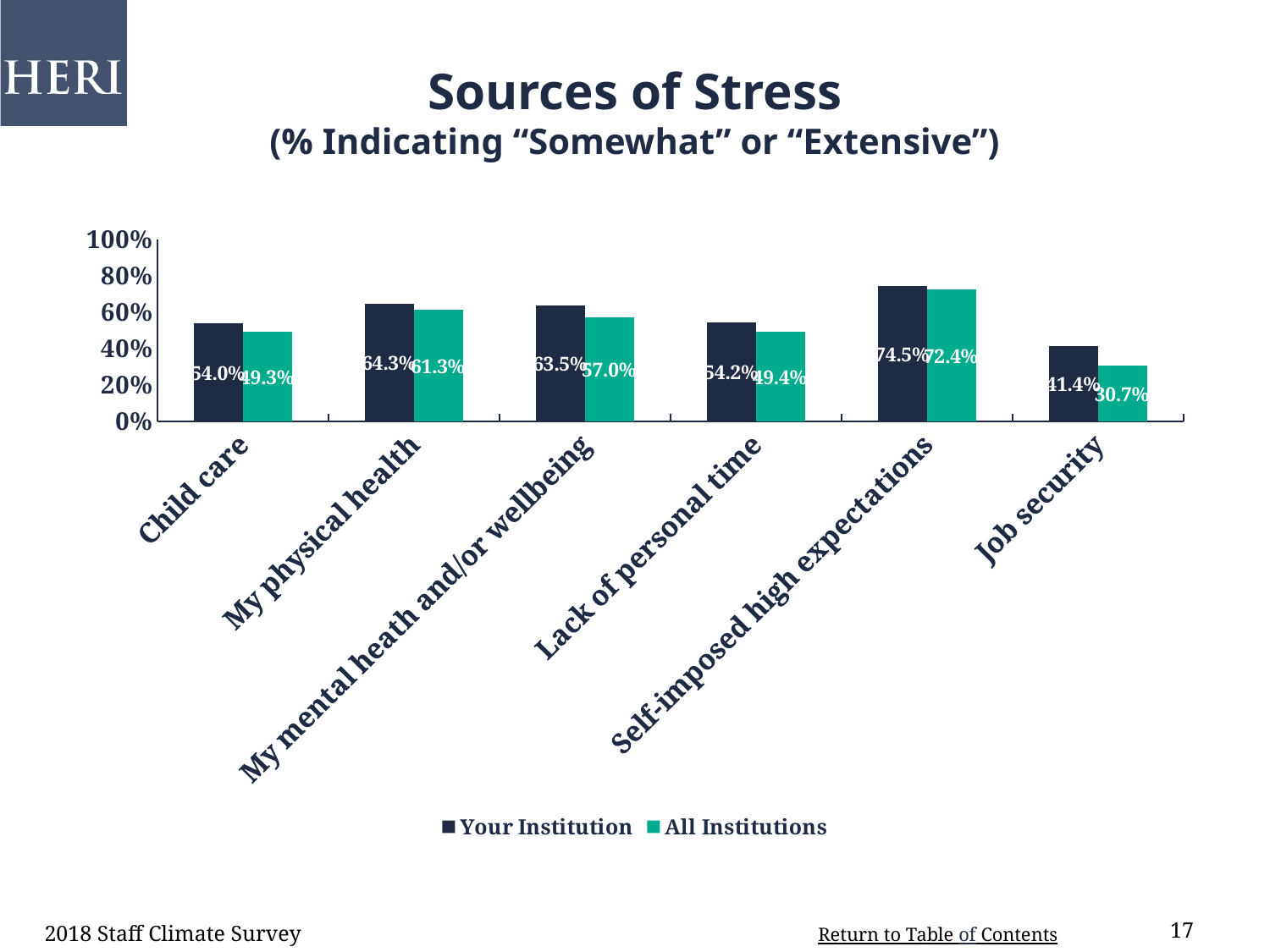
What is the value for Your Institution for Self-imposed high expectations? 74.5% What is the value for All Institutions for Job security? 30.7% How many series does the legend list? 2 Which source of stress has the highest value for Your Institution? Self-imposed high expectations Which source of stress has the lowest value for All Institutions? Job security What is the difference between Your Institution and All Institutions for Job security? 10.7% How many sources of stress are shown on the x axis? 6 Is the value for All Institutions for Child care greater or less than 60%? less What is the value for All Institutions for My physical health? 61.3% What kind of chart is shown on the slide? Bar chart What is the title of the chart? Sources of Stress Which is larger for Lack of personal time: Your Institution or All Institutions? Your Institution